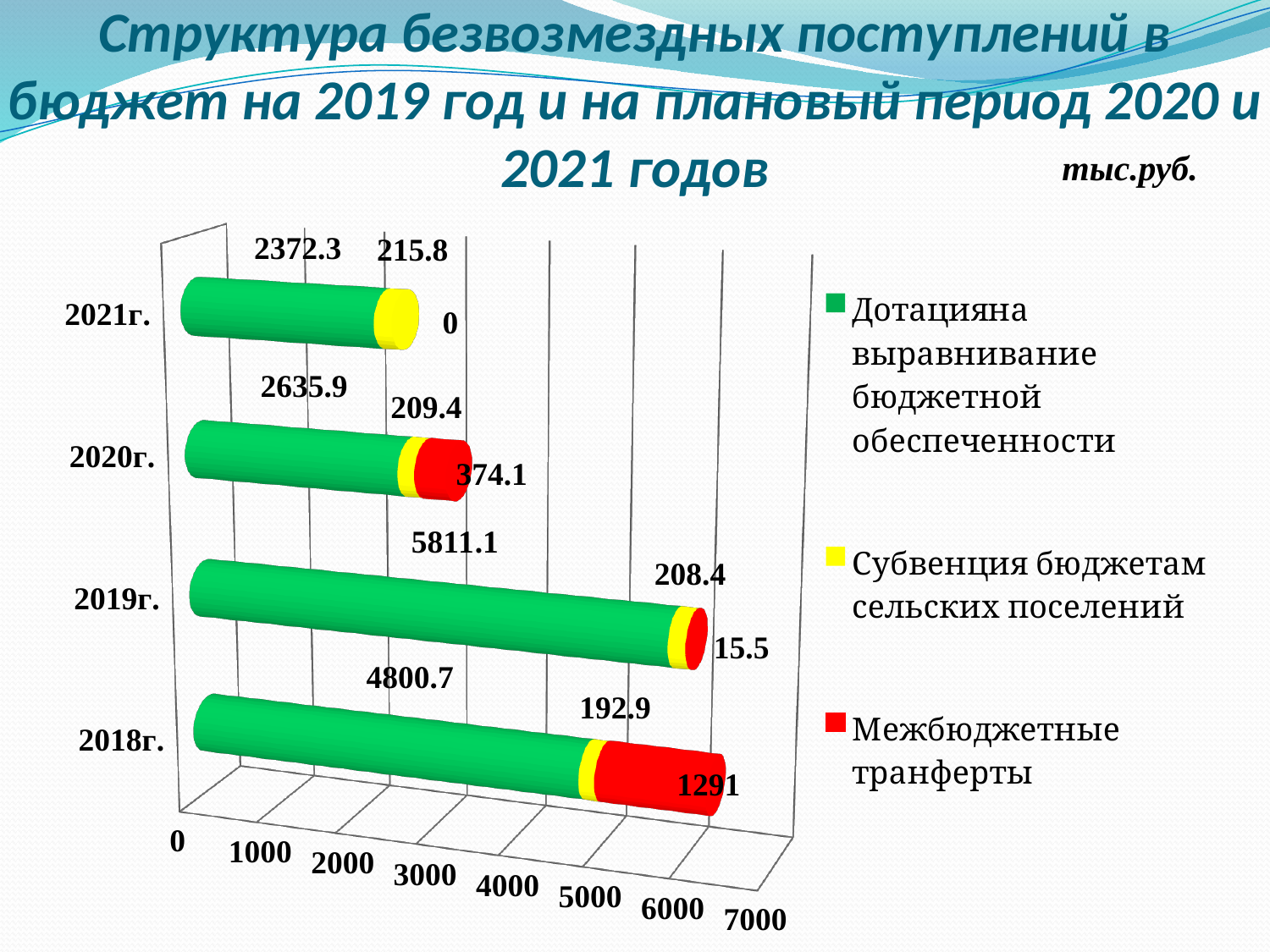
What is the value of Межбюджетные трансферты for 2021г.? 0 Which year has the highest value of Дотация на выравнивание бюджетной обеспеченности? 2019г. Which is larger: Межбюджетные трансферты for 2020г. or for 2019г.? 2020г. How many years are shown on the chart? 4 What is the difference between the Дотация на выравнивание бюджетной обеспеченности values for 2019г. and 2018г.? 1010.4 What kind of chart is shown on the slide? Stacked bar chart How many series does the legend list? 3 What is the value of Дотация на выравнивание бюджетной обеспеченности for 2019г.? 5811.1 What is the value of Межбюджетные трансферты for 2018г.? 1291 What is the total of the stacked bar for 2020г.? 3219.4 What is the value of Субвенция бюджетам сельских поселений for 2021г.? 215.8 Which year has the lowest value of Межбюджетные трансферты? 2021г.